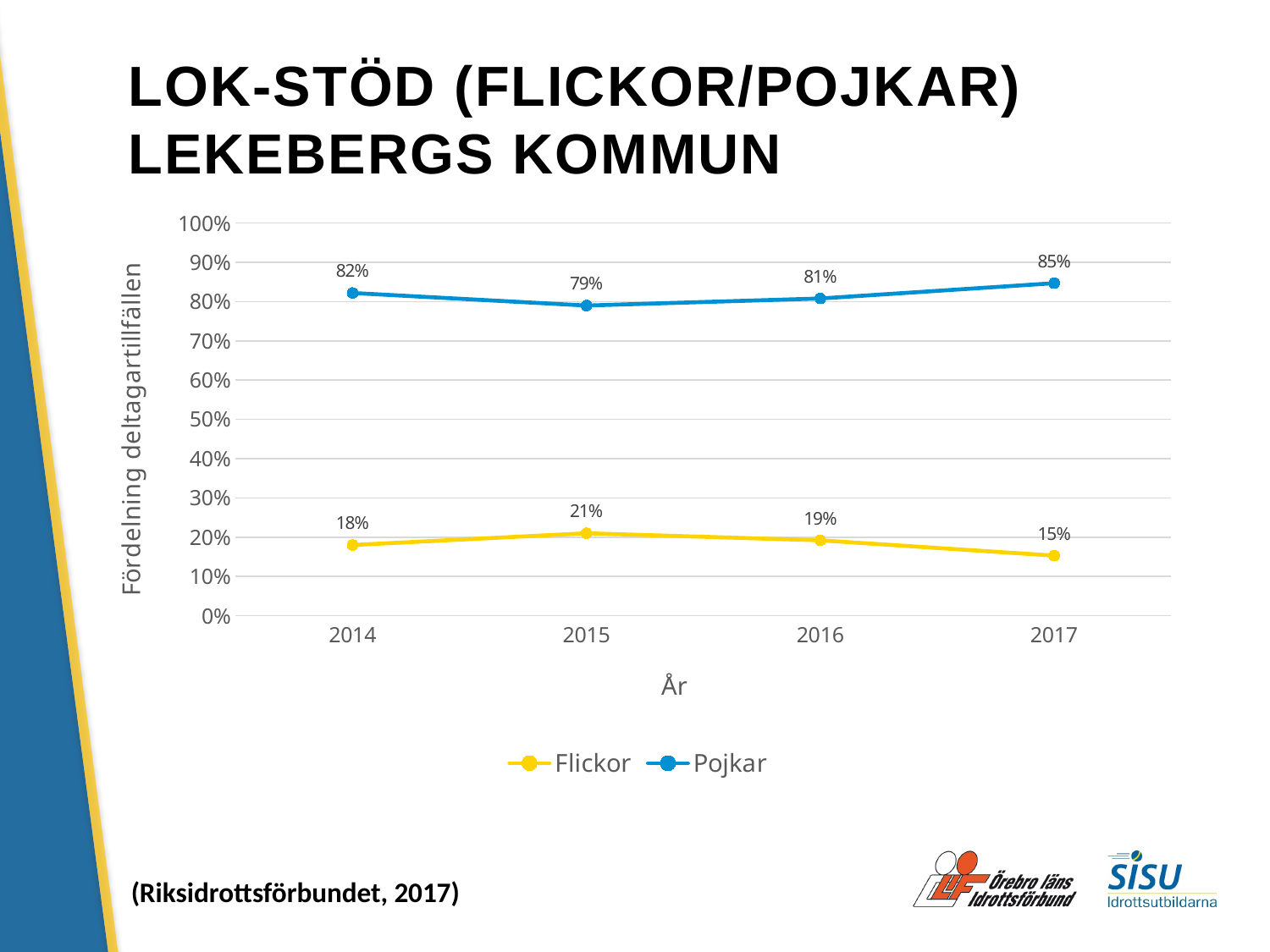
What is the label of the x axis? År What is the value for Pojkar in 2017? 85% How many series does the legend list? 2 Does the Flickor value rise or fall from 2016 to 2017? Fall Which series has the larger value in 2014, Flickor or Pojkar? Pojkar What kind of chart is shown on the slide? Line chart What is the value for Flickor in 2014? 18% What is the difference between the Pojkar and Flickor values in 2016? 62 percentage points In which year is the Flickor value highest? 2015 In which year is the Pojkar value lowest? 2015 How many years are shown on the x axis? 4 What is the value for Flickor in 2015? 21%